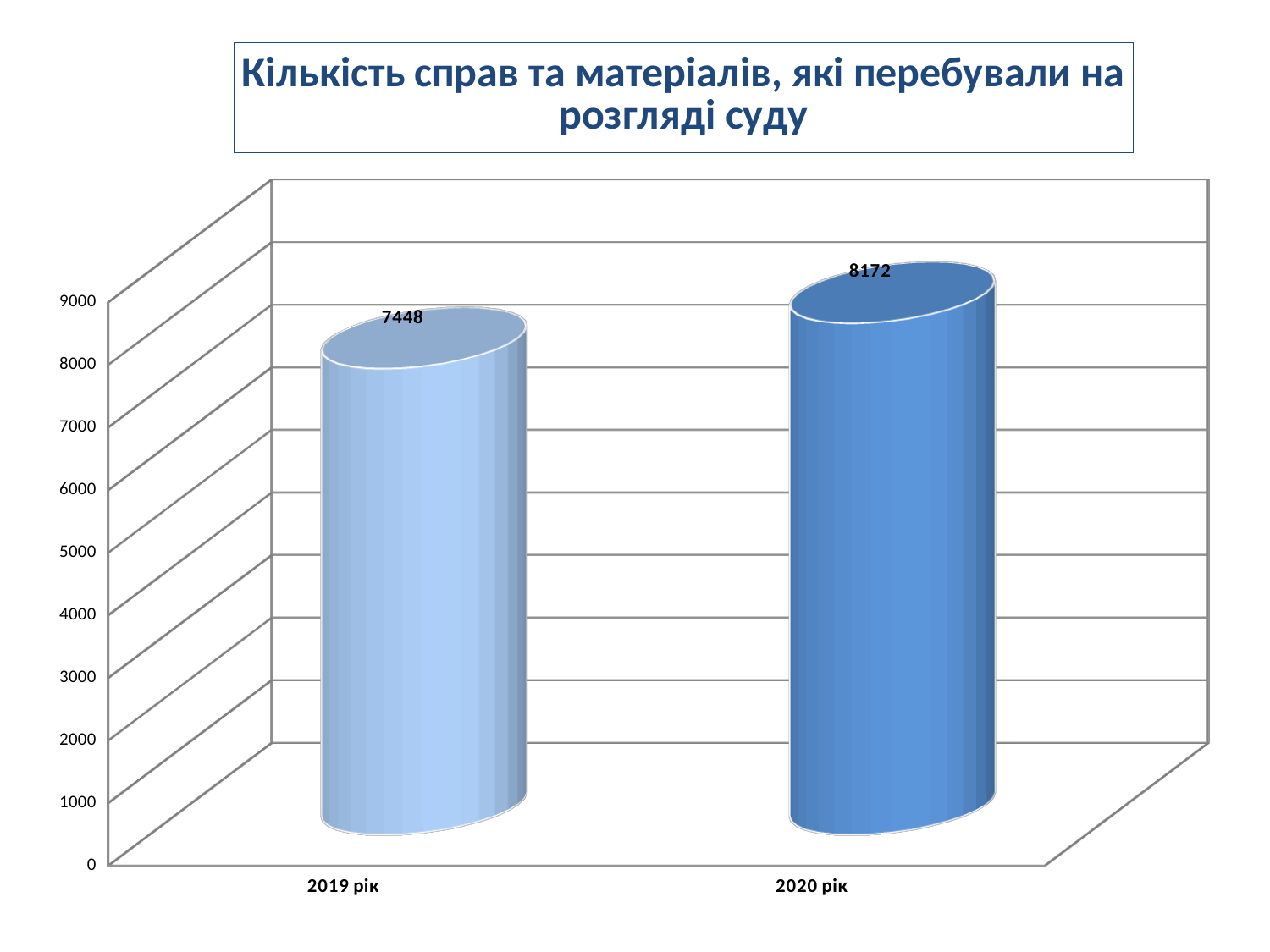
What kind of chart is shown on the slide? bar chart Which year has the lowest value? 2019 рік Do the values rise or fall from 2019 рік to 2020 рік? rise What is the value for 2019 рік? 7448 What is the value for 2020 рік? 8172 What is the difference between the values for 2020 рік and 2019 рік? 724 How many categories are shown on the x axis? 2 Is the value for 2020 рік greater or less than 9000? less What is the title of the chart? Кількість справ та матеріалів, які перебували на розгляді суду Which is larger, the value for 2019 рік or the value for 2020 рік? 2020 рік Is the value for 2019 рік greater or less than 7000? greater Which year has the highest value? 2020 рік